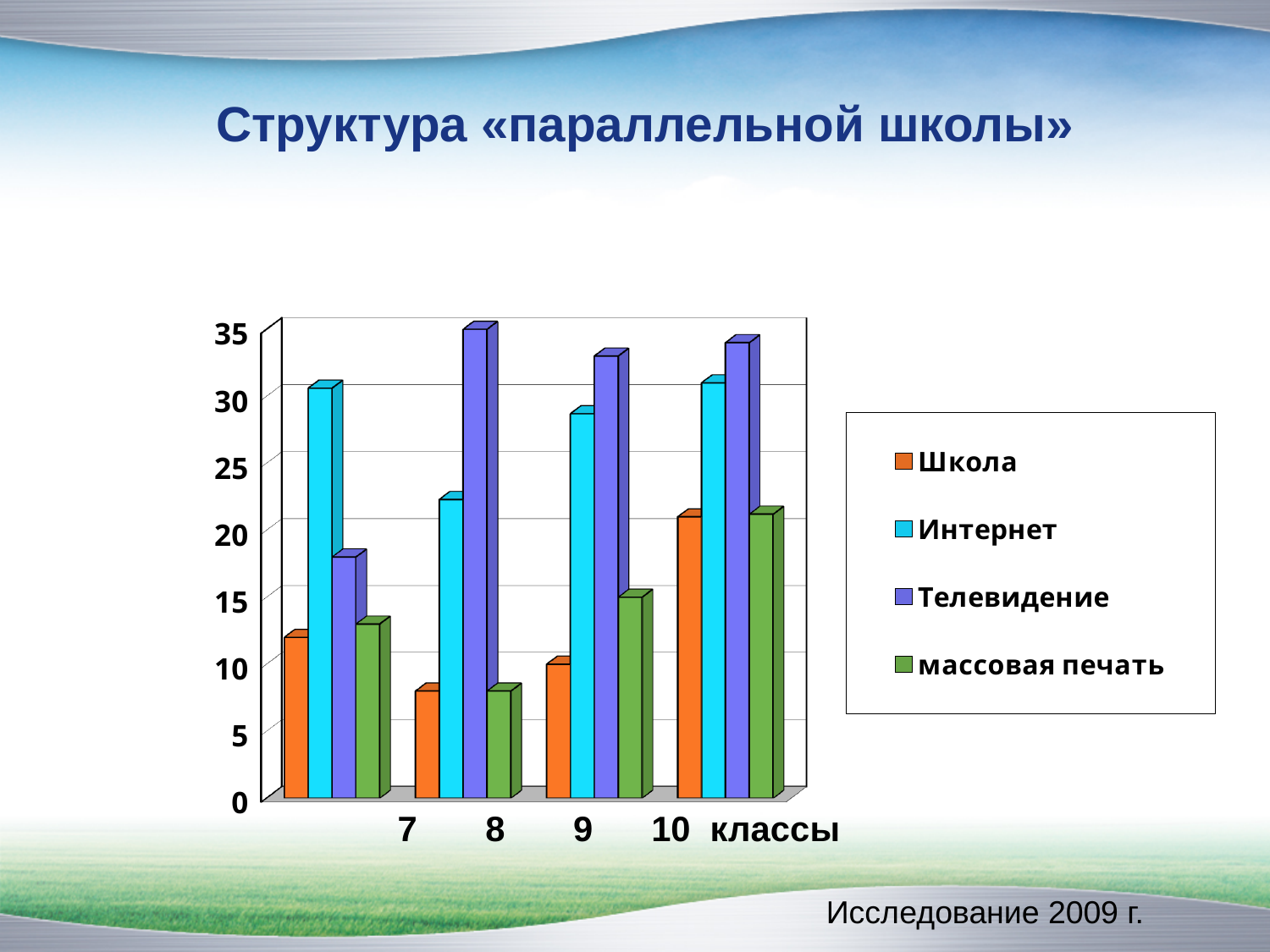
What kind of chart is shown on the slide? bar chart Which series is shown in orange in the legend? Школа In class 7, which is larger: Интернет or Телевидение? Интернет How many class groups are shown along the x axis? 4 Is the value for Телевидение in class 7 greater or less than 20? less In which class is the value for Школа the lowest? 8 Is the value for Школа in class 8 greater or less than 10? less Which series has the highest value in class 8? Телевидение Is the value for Телевидение in class 8 greater or less than 30? greater How many series does the legend list? 4 What is the title of the slide above the chart? Структура «параллельной школы»